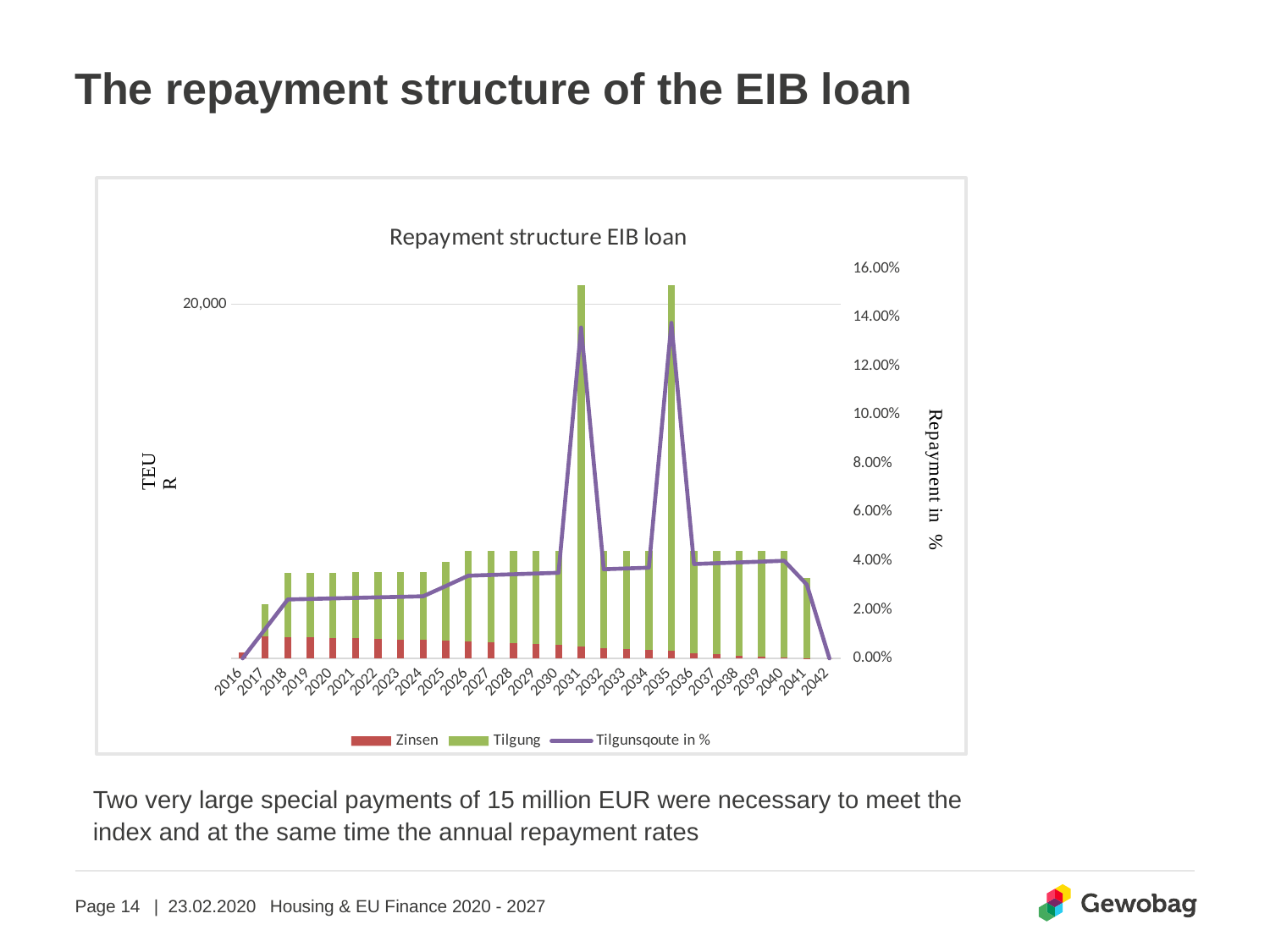
Is the Tilgunsqoute in % value for 2031 greater or less than 12.00%? greater Is the total bar height for 2025 greater or less than 20,000? less Is the Tilgunsqoute in % value for 2020 greater or less than 4.00%? less Which year has the larger Tilgunsqoute in % value, 2031 or 2020? 2031 What kind of chart is shown? Combined stacked bar and line chart Which year has the taller stacked bar, 2025 or 2018? 2025 How many years are shown on the x axis? 27 What are the names of the series listed in the legend? Zinsen, Tilgung, Tilgunsqoute in % What is the title of the chart? Repayment structure EIB loan How many series does the chart legend list? 3 Does the Zinsen (red) portion of the bars rise or fall from 2018 to 2041? fall